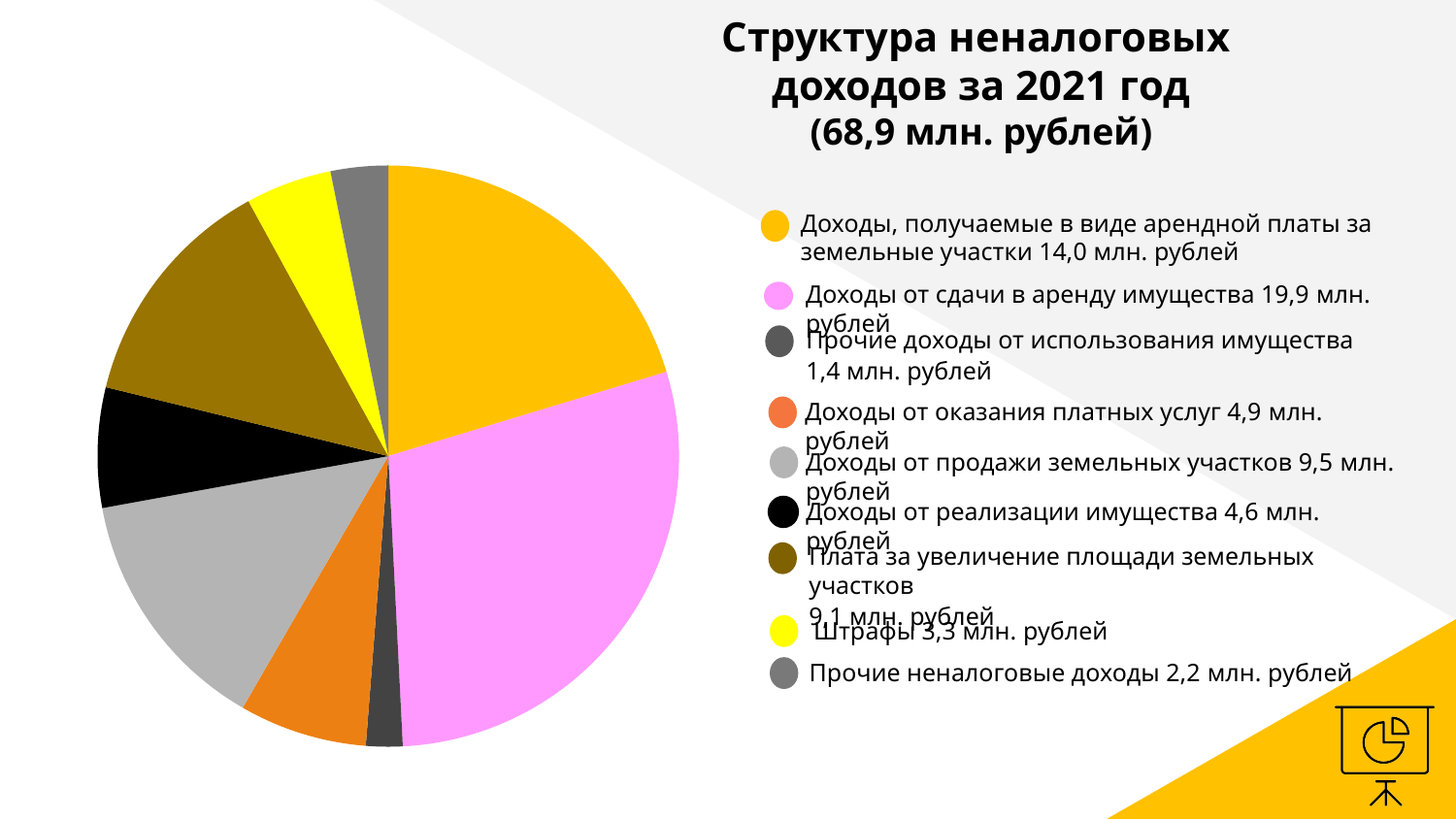
Which is larger: «Доходы от продажи земельных участков» or «Доходы от оказания платных услуг»? Доходы от продажи земельных участков What is the difference between «Доходы от сдачи в аренду имущества» and «Доходы, получаемые в виде арендной платы за земельные участки»? 5,9 млн. рублей Which category has the largest value in the pie chart? Доходы от сдачи в аренду имущества What is the value for «Штрафы»? 3,3 млн. рублей What is the value for «Плата за увеличение площади земельных участков»? 9,1 млн. рублей What is the value for «Доходы, получаемые в виде арендной платы за земельные участки»? 14,0 млн. рублей What total amount of non-tax revenue for 2021 is stated in the chart title? 68,9 млн. рублей What is the value for «Доходы от сдачи в аренду имущества»? 19,9 млн. рублей What kind of chart is shown on the slide? Pie chart What colour is the slice for «Доходы от реализации имущества»? Black How many categories (slices) does the pie chart have? 9 Which category has the smallest value in the pie chart? Прочие доходы от использования имущества